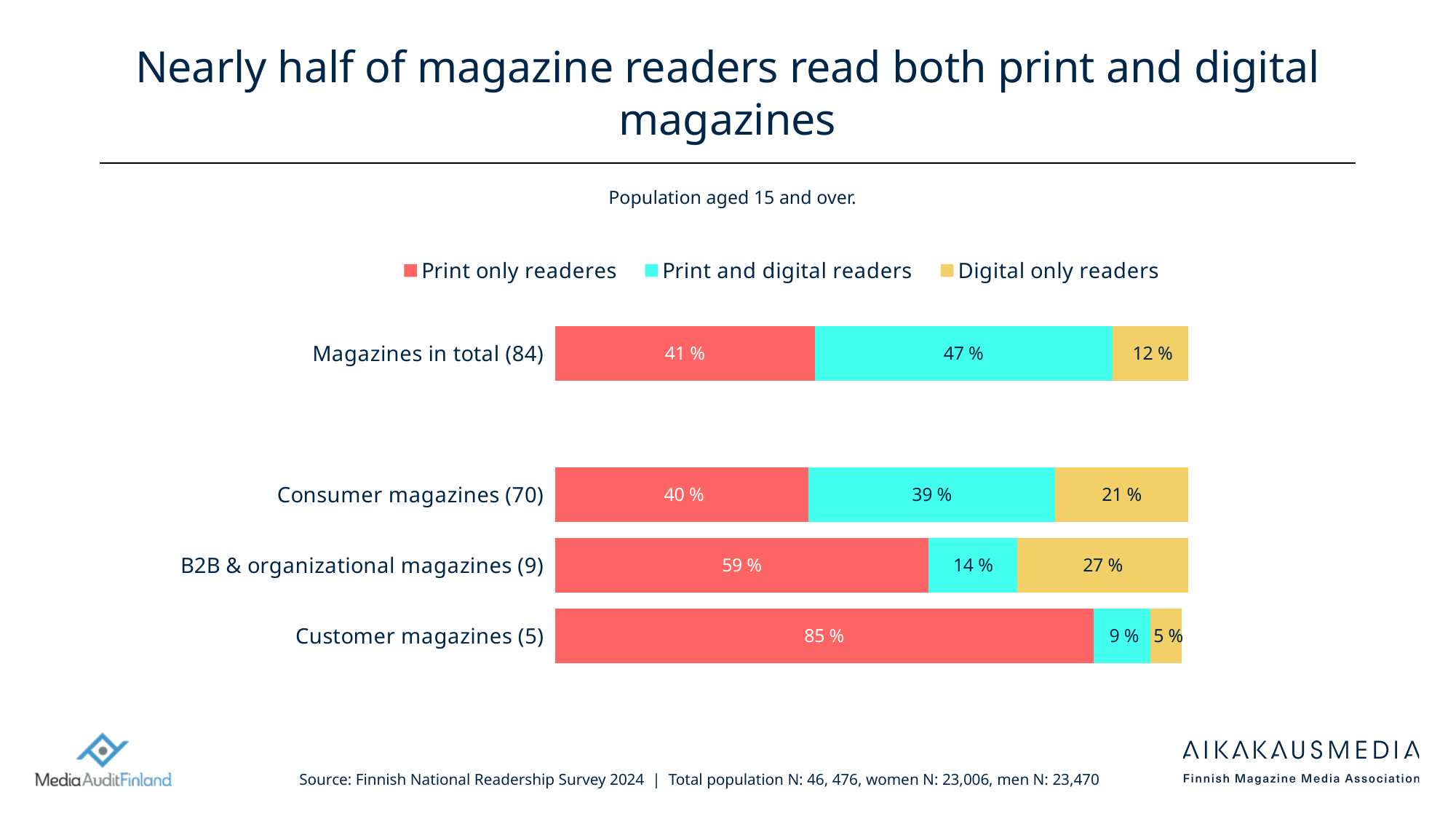
How many categories are shown in the chart? 4 Which colour represents Digital only readers in the chart? Yellow What is the Digital only readers value for B2B & organizational magazines (9)? 27 % What is the Print and digital readers value for Consumer magazines (70)? 39 % What is the Print only readers value for Customer magazines (5)? 85 % What is the difference between the Print only readers values for B2B & organizational magazines (9) and Consumer magazines (70)? 19 % What kind of chart is shown on the slide? Stacked bar chart Which category has the lowest Digital only readers share? Customer magazines (5) How many series does the legend list? 3 Which is larger: the Digital only readers value for Consumer magazines (70) or for Magazines in total (84)? Consumer magazines (70) Which category has the highest Print only readers share? Customer magazines (5) What percentage of Magazines in total (84) readers are Print and digital readers? 47 %